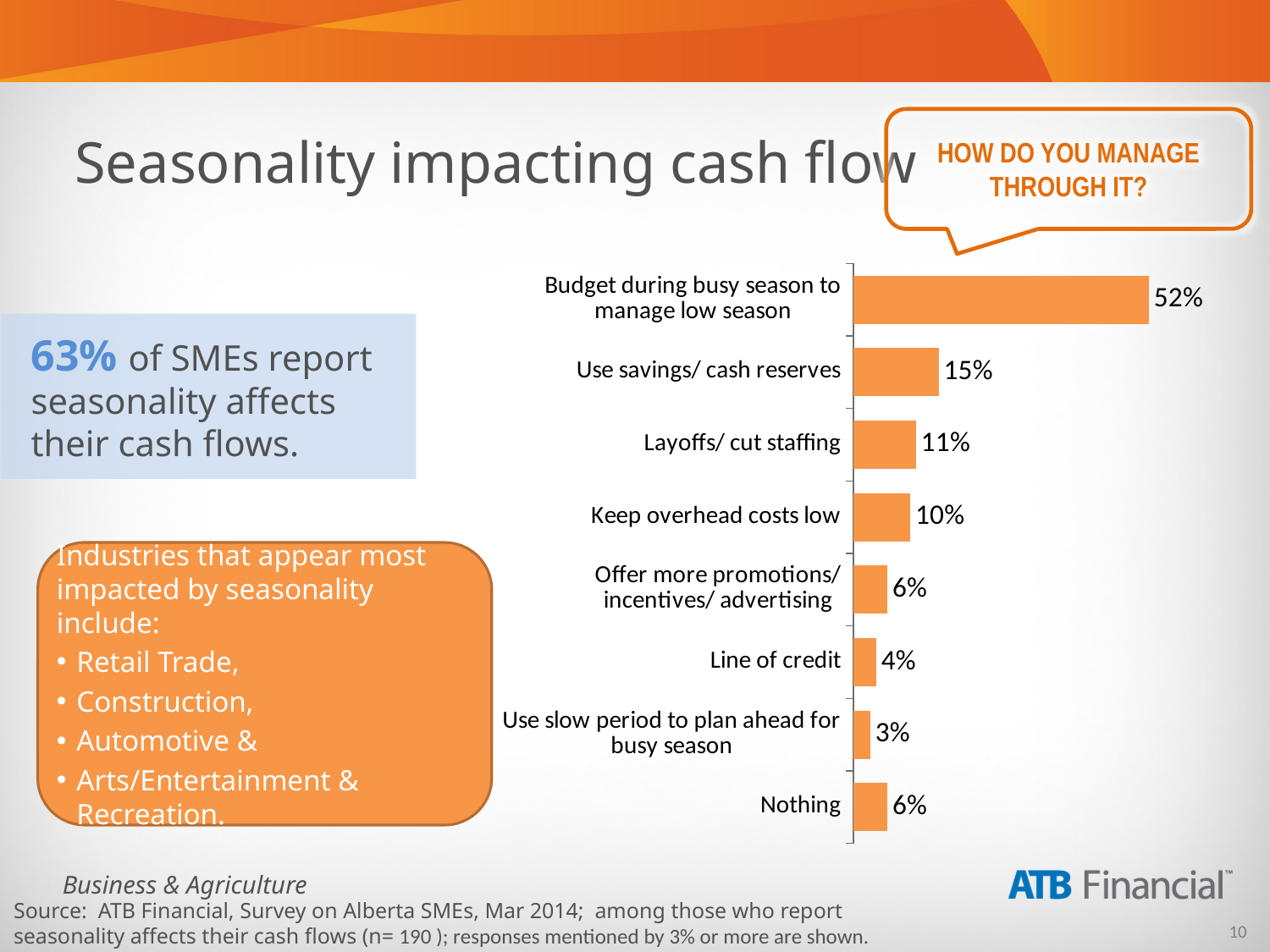
What is the value for 'Use savings/ cash reserves'? 15% What is the difference between 'Budget during busy season to manage low season' and 'Use savings/ cash reserves'? 37% What percentage of respondents said 'Layoffs/ cut staffing'? 11% What question does the callout above the chart ask? HOW DO YOU MANAGE THROUGH IT? Which category has the lowest value in the chart? Use slow period to plan ahead for busy season What is the difference between 'Keep overhead costs low' and 'Line of credit'? 6% What kind of chart is shown on the slide? Bar chart Which is larger: 'Layoffs/ cut staffing' or 'Keep overhead costs low'? Layoffs/ cut staffing What is the value for 'Use slow period to plan ahead for busy season'? 3% What percentage of SMEs budget during the busy season to manage the low season? 52% Which category has the highest value in the chart? Budget during busy season to manage low season How many categories are shown in the chart? 8